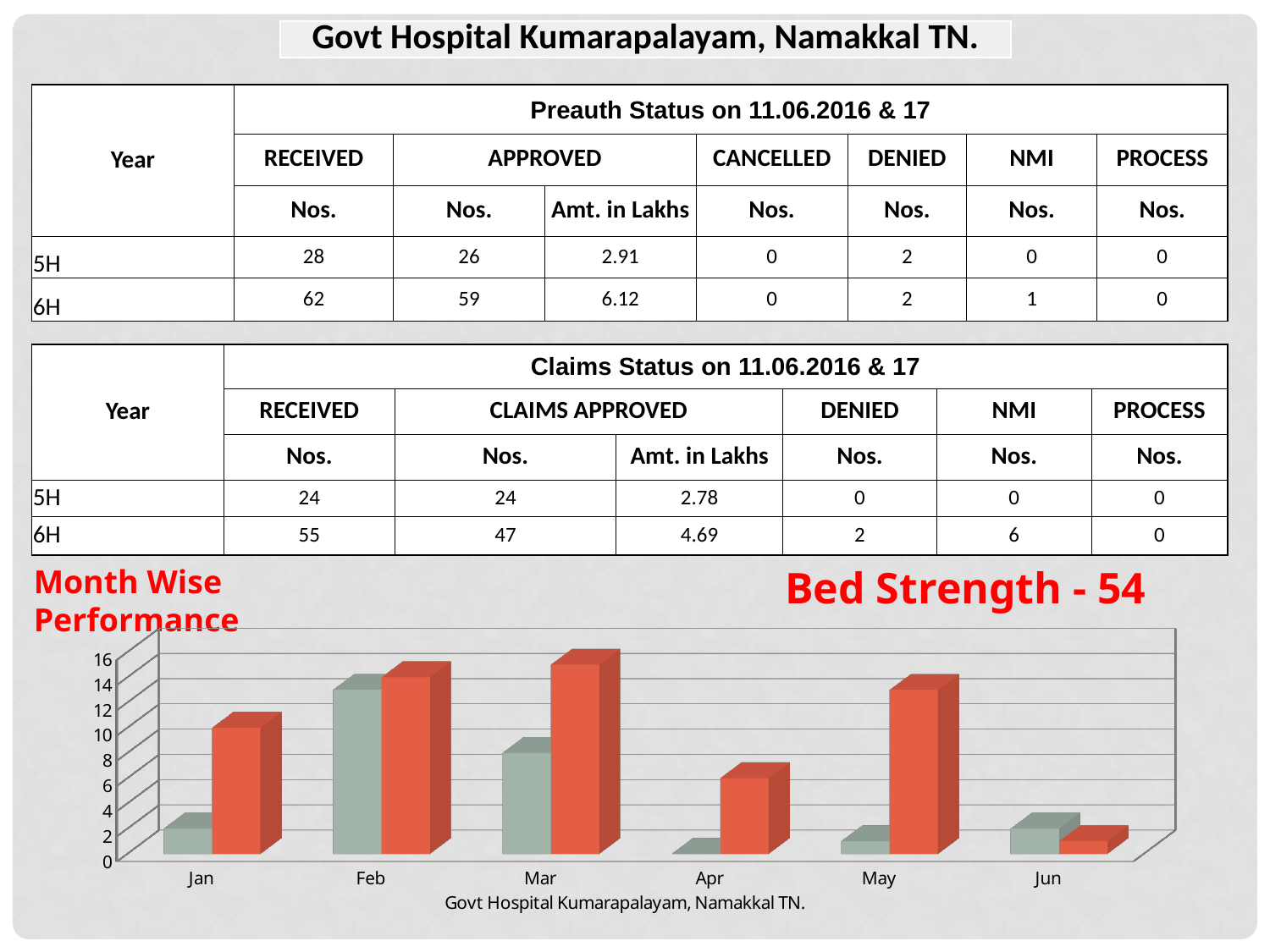
What kind of chart is shown under the heading 'Month Wise Performance'? bar chart In the Month Wise Performance chart, is the grey bar for Jan greater or less than 4? less In the Month Wise Performance chart, is the red bar for Jan greater or less than 8? greater In the Month Wise Performance chart, is the grey bar for Feb greater or less than 10? greater What text appears below the x axis of the Month Wise Performance chart? Govt Hospital Kumarapalayam, Namakkal TN. In the Month Wise Performance chart, do the grey bars rise or fall from Feb to Apr? fall How many months are shown on the x axis of the Month Wise Performance chart? 6 In the Month Wise Performance chart, which month has the shortest red bar? Jun In the Month Wise Performance chart, which month has the tallest grey bar? Feb In the Month Wise Performance chart, which is larger for Jun: the grey bar or the red bar? the grey bar